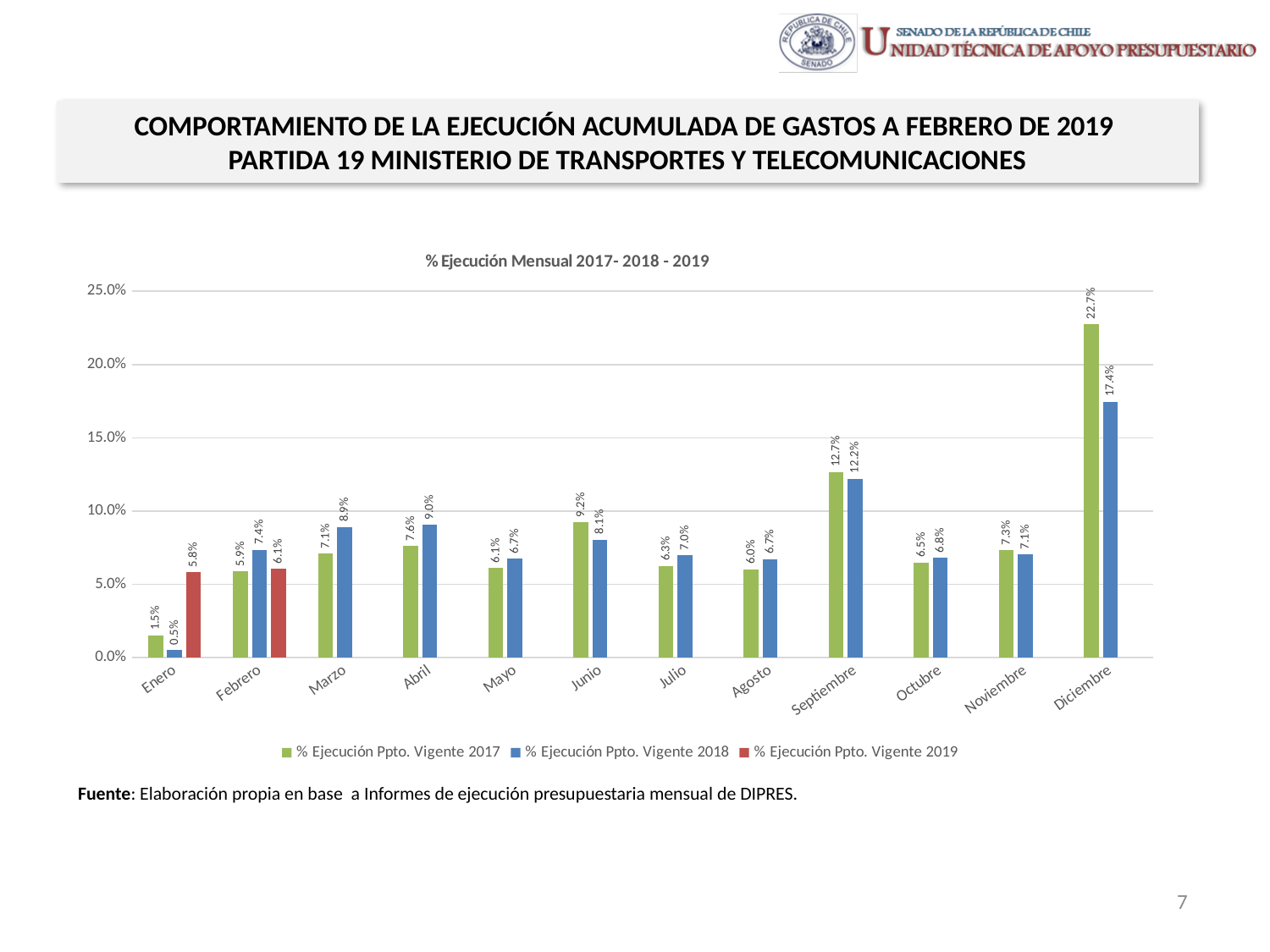
What is the value for Septiembre in the % Ejecución Ppto. Vigente 2018 series? 12.2% What is the value for Diciembre in the % Ejecución Ppto. Vigente 2017 series? 22.7% What is the difference between the 2017 and 2018 values for Diciembre? 5.3% What kind of chart is shown on the slide? Bar chart What is the value for Enero in the % Ejecución Ppto. Vigente 2019 series? 5.8% How many series does the legend list? 3 Is the value for Septiembre in the 2017 series greater or less than 10.0%? greater What is the difference between the 2019 and 2018 values for Febrero? 1.3% How many months are shown on the x axis? 12 Which is larger for Junio: the 2017 value or the 2018 value? 2017 (9.2%) Which month has the highest value in the % Ejecución Ppto. Vigente 2018 series? Diciembre Which month has the lowest value in the % Ejecución Ppto. Vigente 2017 series? Enero